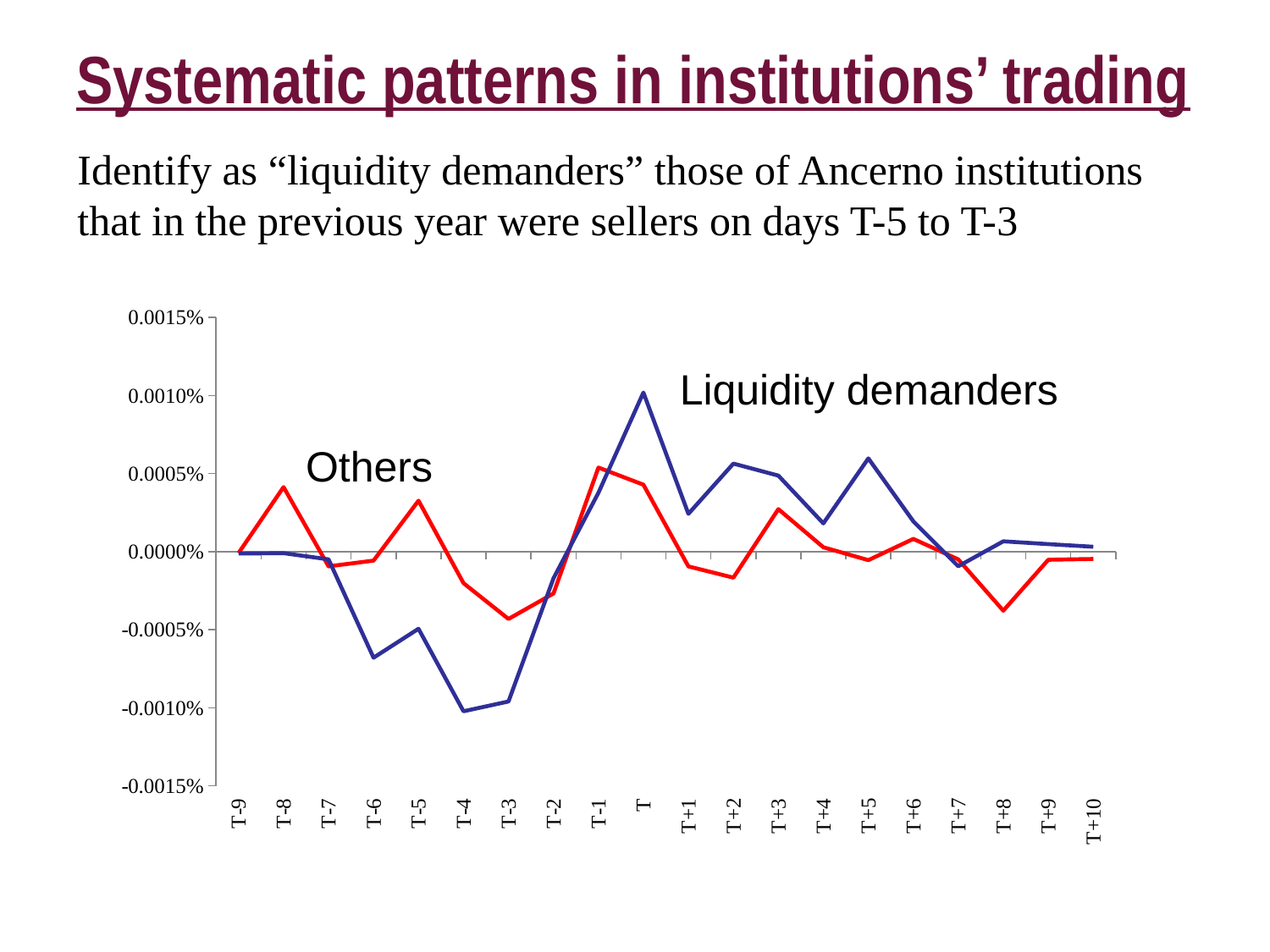
At T-5, which series has the larger value, Liquidity demanders or Others? Others Does the Liquidity demanders series rise or fall from T-3 to T? rise At T+5, which series has the larger value, Liquidity demanders or Others? Liquidity demanders Is the value for Liquidity demanders at T-6 greater or less than -0.0005%? less Is the value for Liquidity demanders at T greater or less than 0.0005%? greater Is the value for Others at T+8 greater or less than 0.0000%? less How many points are on the x axis of the chart, from T-9 to T+10? 20 What kind of chart is shown on the slide? line chart At which day does the Others series reach its highest value? T-1 How many series are plotted on the chart? 2 At which day does the Liquidity demanders series reach its highest value? T